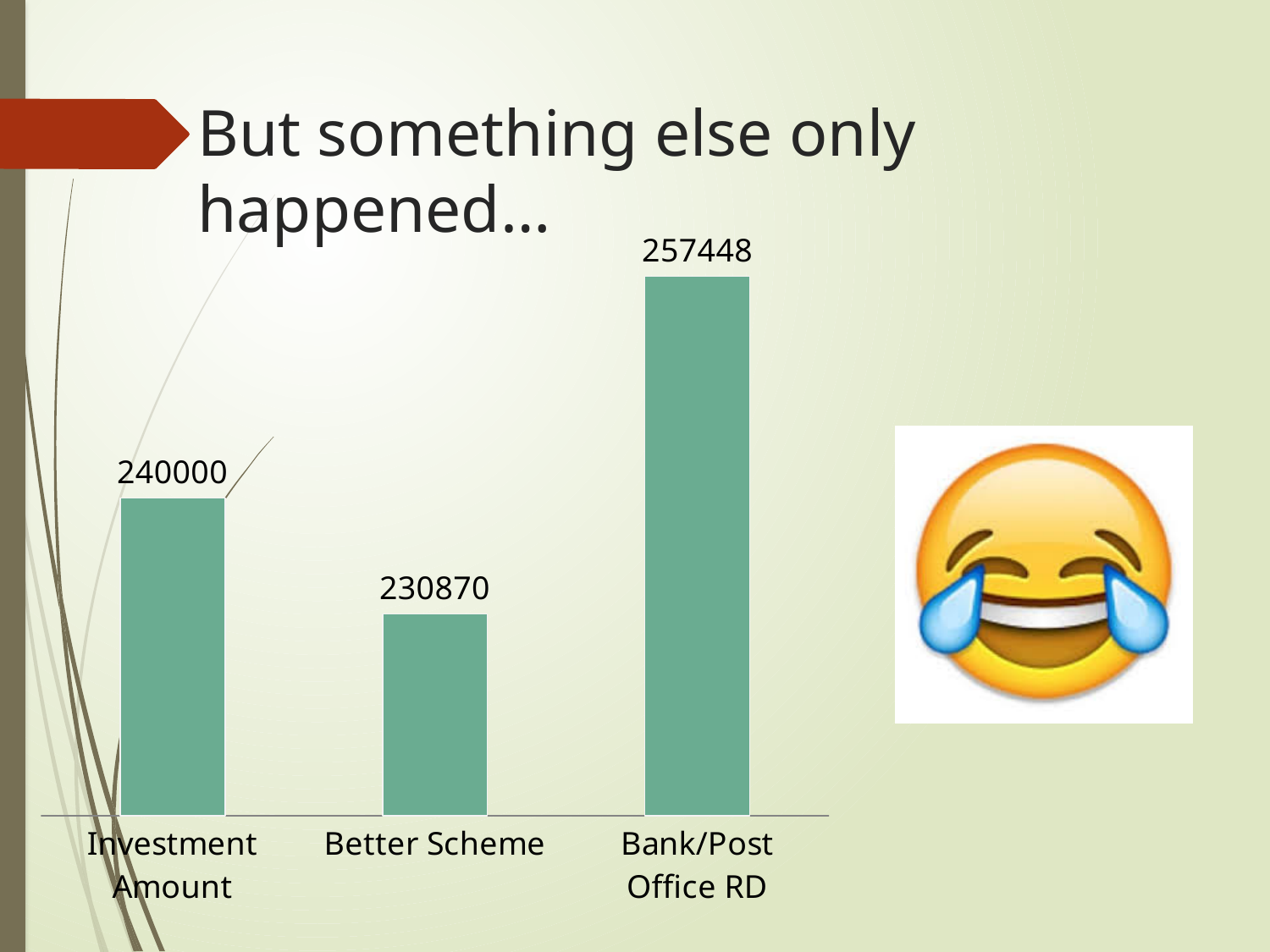
How many categories are shown in the chart? 3 Which category has the lowest value? Better Scheme What colour are the bars in the chart? Green What is the value for Bank/Post Office RD? 257448 What is the difference between the values for Investment Amount and Better Scheme? 9130 Which is larger, the value for Better Scheme or the value for Bank/Post Office RD? Bank/Post Office RD What is the value for Better Scheme? 230870 What is the value for Investment Amount? 240000 Which category has the highest value? Bank/Post Office RD What kind of chart is shown on the slide? Bar chart What is the title text on the slide above the chart? But something else only happened... What is the difference between the values for Bank/Post Office RD and Investment Amount? 17448